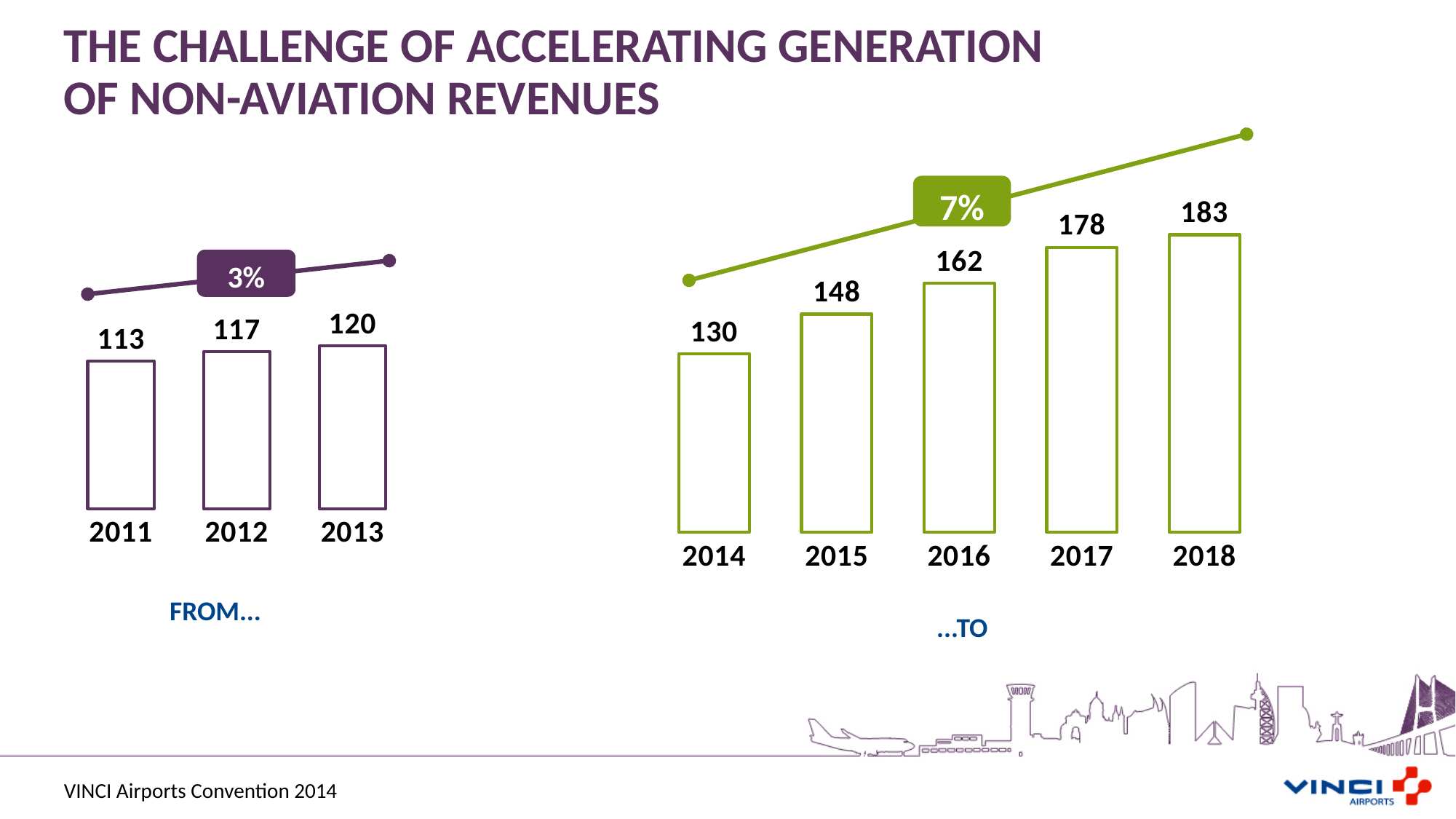
How many bars are in the right chart (2014–2018)? 5 In the left chart (2011–2013), what is the value for 2012? 117 In the right chart (2014–2018), what is the difference between the values for 2018 and 2014? 53 How many bars are in the left chart (2011–2013)? 3 Which is larger: the value for 2013 in the left chart or the value for 2014 in the right chart? 2014 In the right chart (2014–2018), what is the value for 2016? 162 What growth rate is shown in the label above the right chart (2014–2018)? 7% In the left chart (2011–2013), what is the difference between the values for 2013 and 2011? 7 In the left chart (2011–2013), which year has the highest value? 2013 In the right chart (2014–2018), which year has the lowest value? 2014 In the right chart (2014–2018), what is the value for 2018? 183 What type of chart is used on the slide? Bar chart